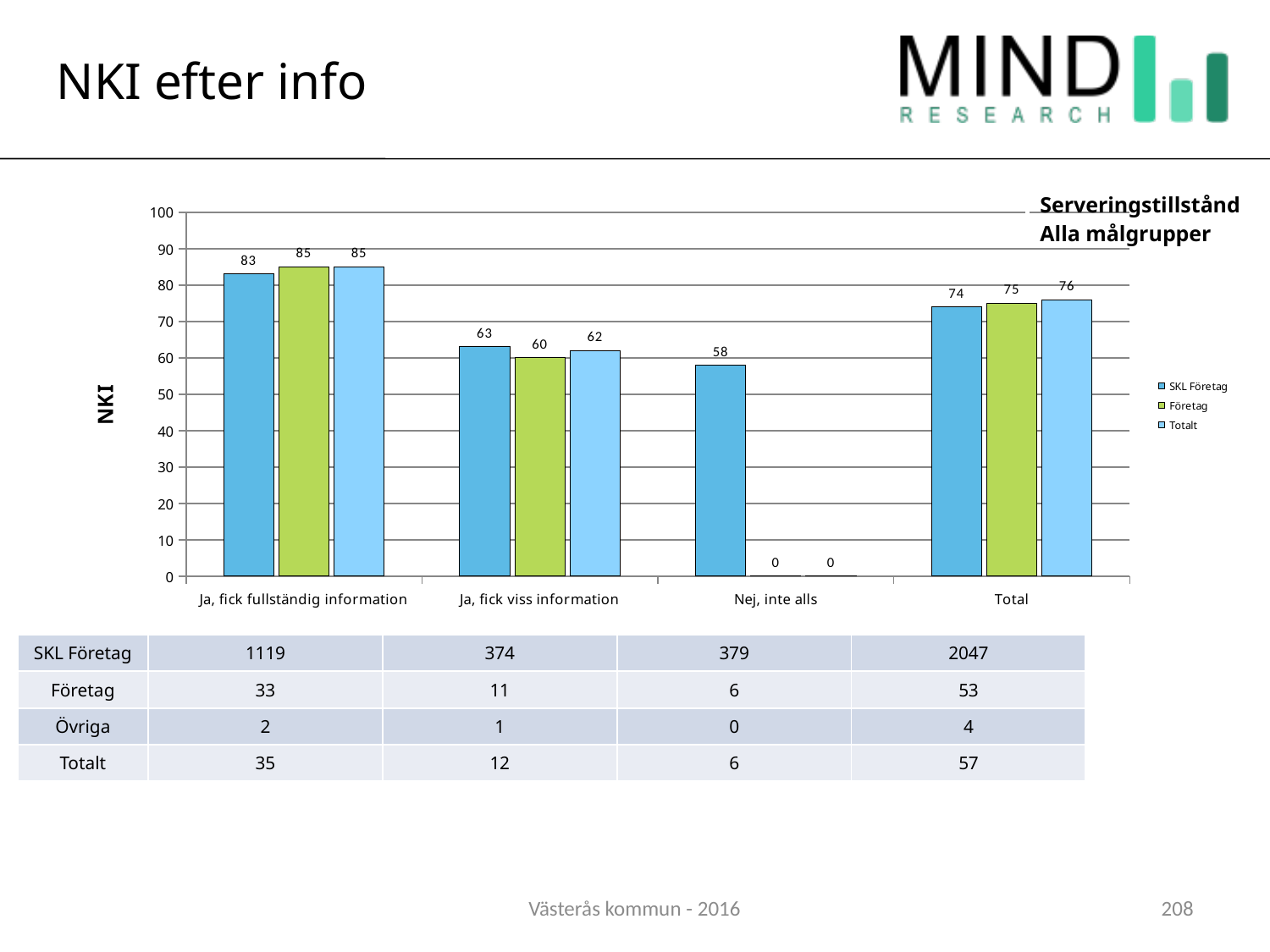
How many series does the chart legend list? 3 What is the NKI value for SKL Företag in the 'Ja, fick fullständig information' category? 83 Which category has the highest NKI value for SKL Företag? Ja, fick fullständig information What is the difference between the SKL Företag values for 'Ja, fick fullständig information' and 'Ja, fick viss information'? 20 Which category has the lowest NKI value for SKL Företag? Nej, inte alls What is the NKI value for SKL Företag in the 'Nej, inte alls' category? 58 What is the NKI value for Totalt in the 'Total' category? 76 Which is larger: the Totalt value for 'Ja, fick fullständig information' or the Totalt value for 'Total'? Ja, fick fullständig information What is the label of the y axis of the chart? NKI What kind of chart is shown on the slide? Bar chart What is the NKI value for Företag in the 'Ja, fick viss information' category? 60 How many categories are shown on the x axis of the chart? 4